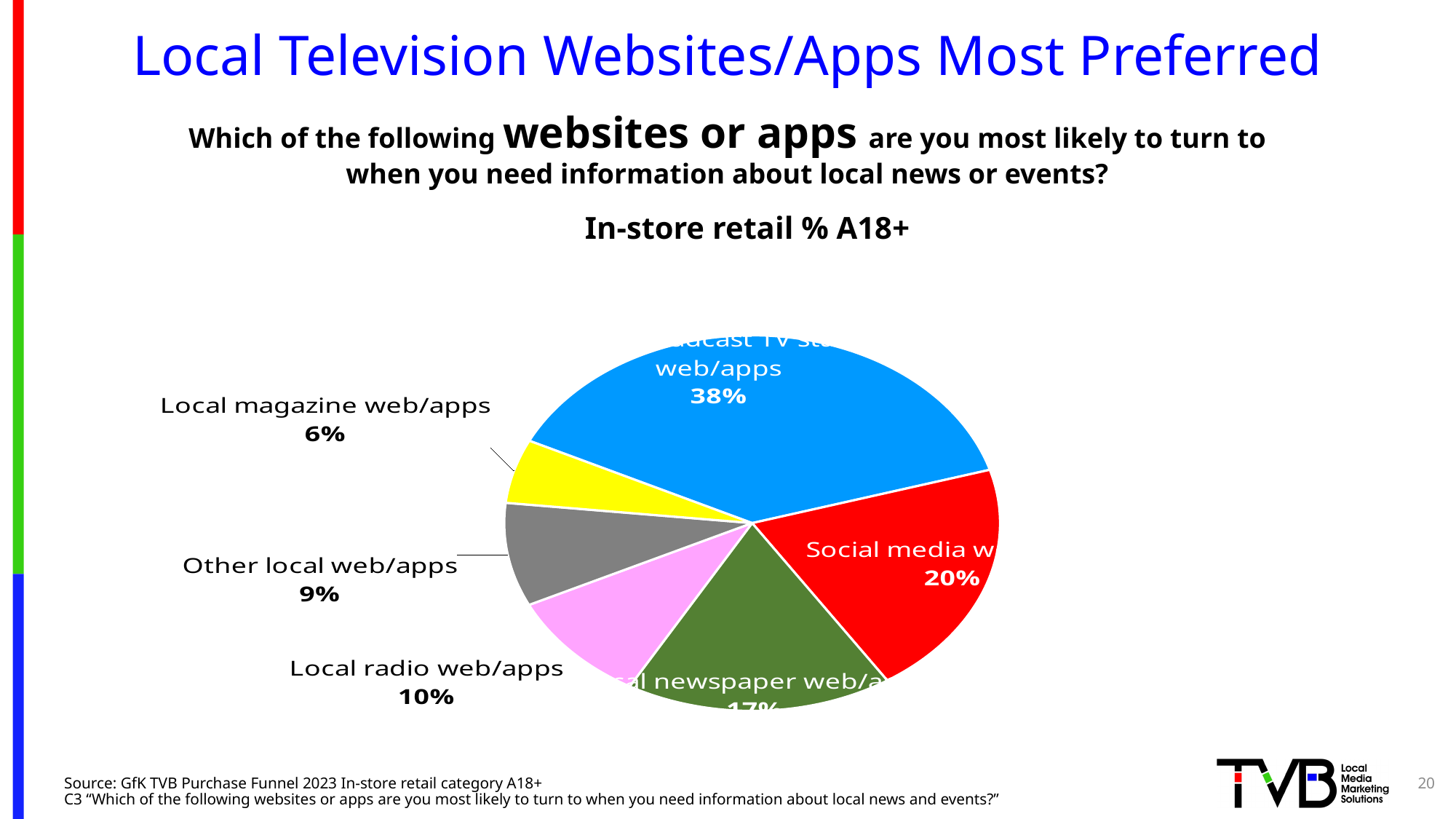
What percentage is shown for Local magazine web/apps? 6% What percentage is shown on the largest slice of the pie? 38% Which is larger, Local radio web/apps or Other local web/apps? Local radio web/apps What percentage is shown for Other local web/apps? 9% What percentage is shown for Local radio web/apps? 10% What percentage is shown for the Social media slice? 20% Which category has the smallest slice of the pie? Local magazine web/apps What is the title of the chart? In-store retail % A18+ How many slices does the pie chart have? 6 What type of chart is shown on the slide? pie chart What colour is the Local magazine web/apps slice? yellow What is the difference between Local radio web/apps and Local magazine web/apps? 4%